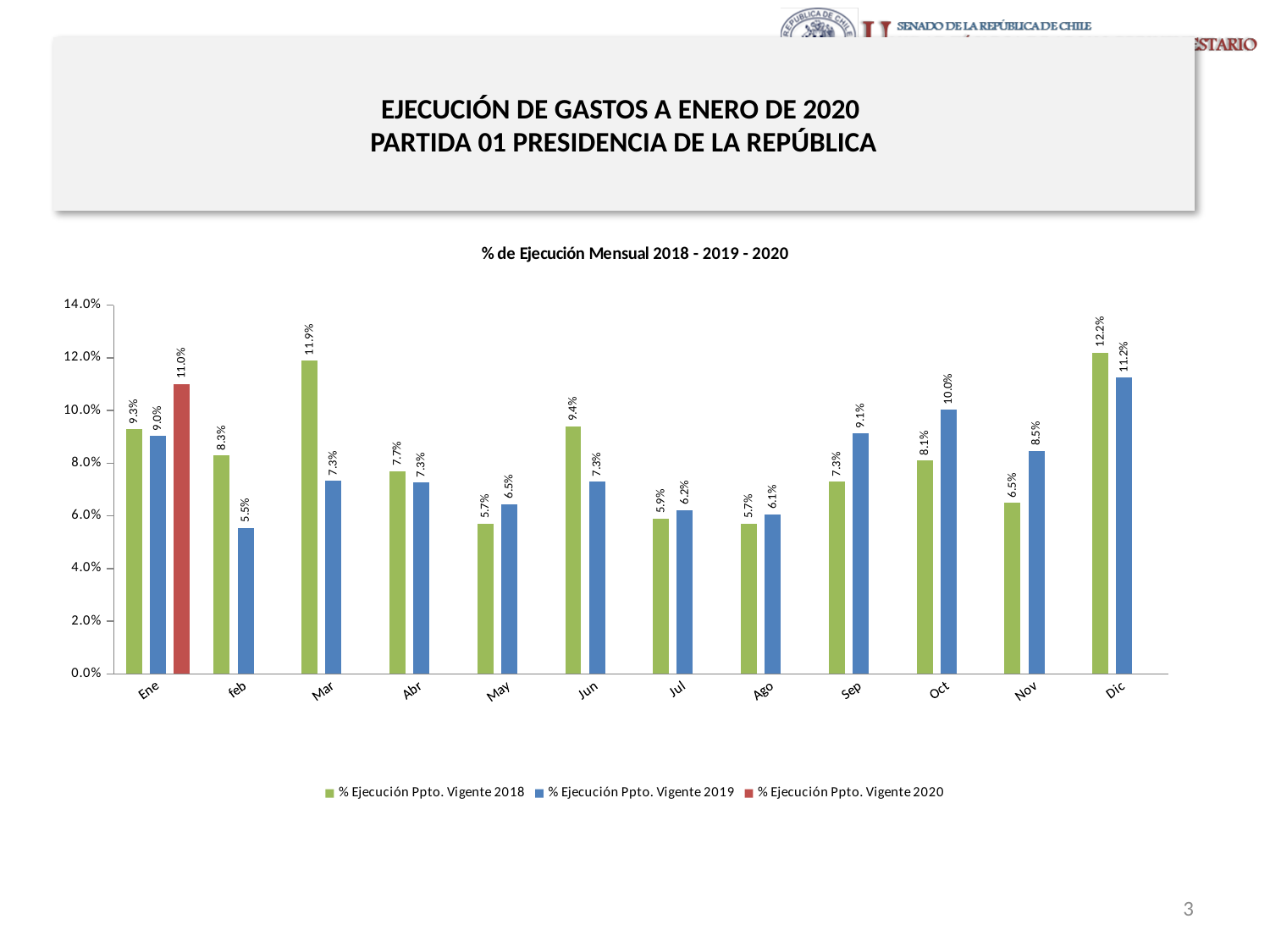
How many series does the legend list? 3 Which is larger for Sep: the 2018 value or the 2019 value? 2019 value What is the difference between the 2018 and 2019 values for feb? 2.8% Is the value for Dic in the 2019 series greater or less than 10.0%? greater How many months are shown on the x axis? 12 What kind of chart is shown on the slide? Bar chart Which month has the highest value in the % Ejecución Ppto. Vigente 2018 series? Dic Which month has the lowest value in the % Ejecución Ppto. Vigente 2019 series? feb What is the value for Ene in the % Ejecución Ppto. Vigente 2020 series? 11.0% What is the value for Oct in the % Ejecución Ppto. Vigente 2019 series? 10.0% What is the value for Mar in the % Ejecución Ppto. Vigente 2018 series? 11.9% What is the title of the chart? % de Ejecución Mensual 2018 - 2019 - 2020